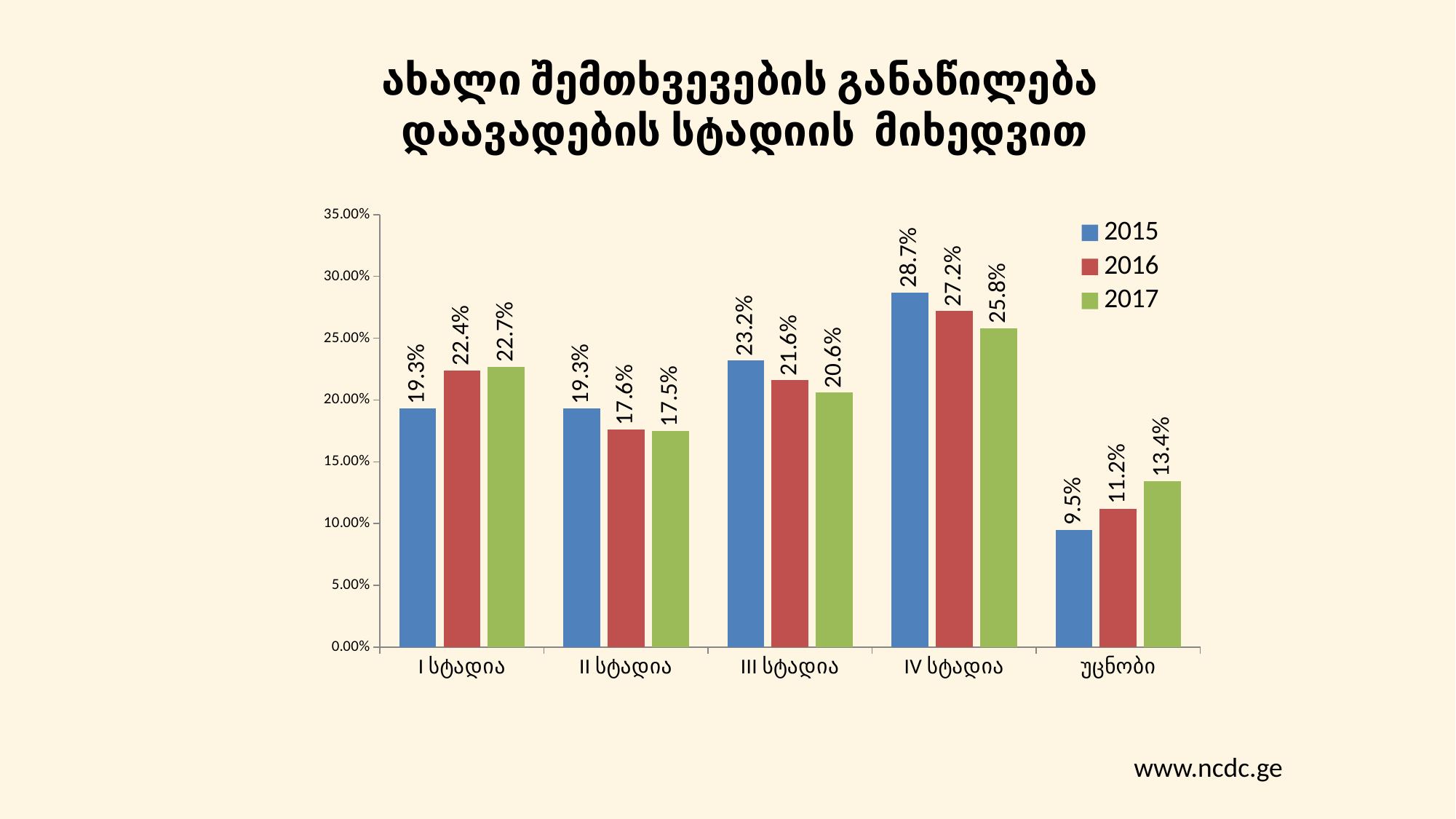
Which category has the lowest value for the 2017 series? უცნობი Which category has the highest value for the 2015 series? IV სტადია What is the difference between the 2015 and 2017 values in the IV სტადია category? 2.9% How many series does the legend list? 3 What is the value for 2017 in the IV სტადია category? 25.8% What kind of chart is shown on the slide? bar chart Is the 2016 value for უცნობი greater or less than 15.00%? less How many categories are shown on the x axis? 5 What is the value for 2015 in the უცნობი category? 9.5% Do the values in the უცნობი category rise or fall from 2015 to 2017? rise Which is larger in the I სტადია category: the 2015 value or the 2016 value? 2016 What is the value for 2016 in the III სტადია category? 21.6%